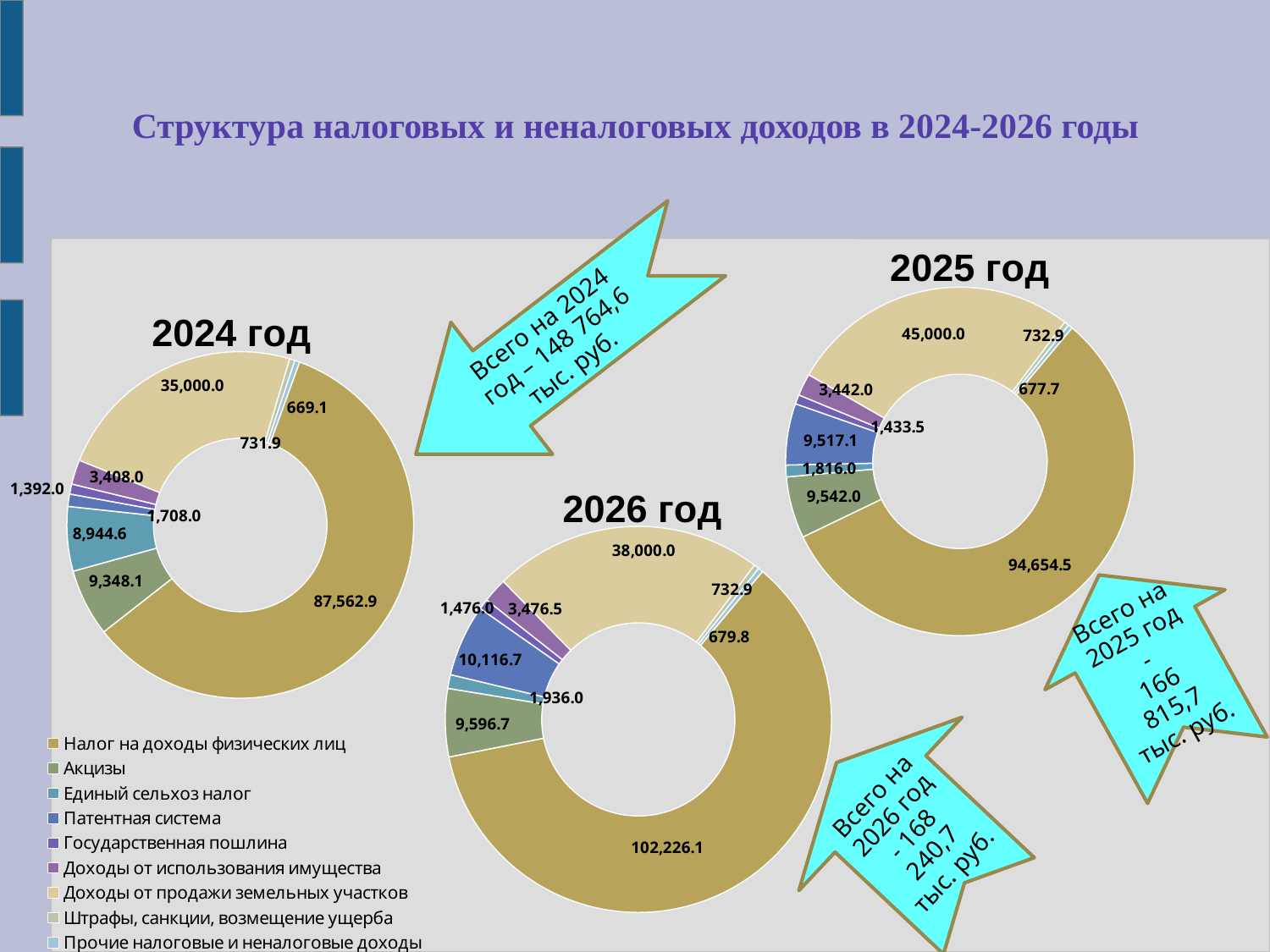
Which is larger: Акцизы in the 2024 год chart or Акцизы in the 2026 год chart? 2026 год (9,596.7) How many charts are shown on the slide? 3 In the 2025 год chart, what is the value for Акцизы? 9,542.0 By how much does Налог на доходы физических лиц in the 2026 год chart exceed the same category in the 2025 год chart? 7,571.6 In the 2025 год chart, what is the value for Налог на доходы физических лиц? 94,654.5 In the 2026 год chart, what is the value for Доходы от продажи земельных участков? 38,000.0 How many categories does the legend list? 9 What kind of chart is used for the 2024 год data? Doughnut (pie) chart In the 2026 год chart, what is the value for Налог на доходы физических лиц? 102,226.1 In the 2024 год chart, what is the value for Налог на доходы физических лиц? 87,562.9 According to the arrow callout, what is the total for 2025 год? 166 815,7 тыс. руб. In the 2024 год chart, which category has the largest slice? Налог на доходы физических лиц